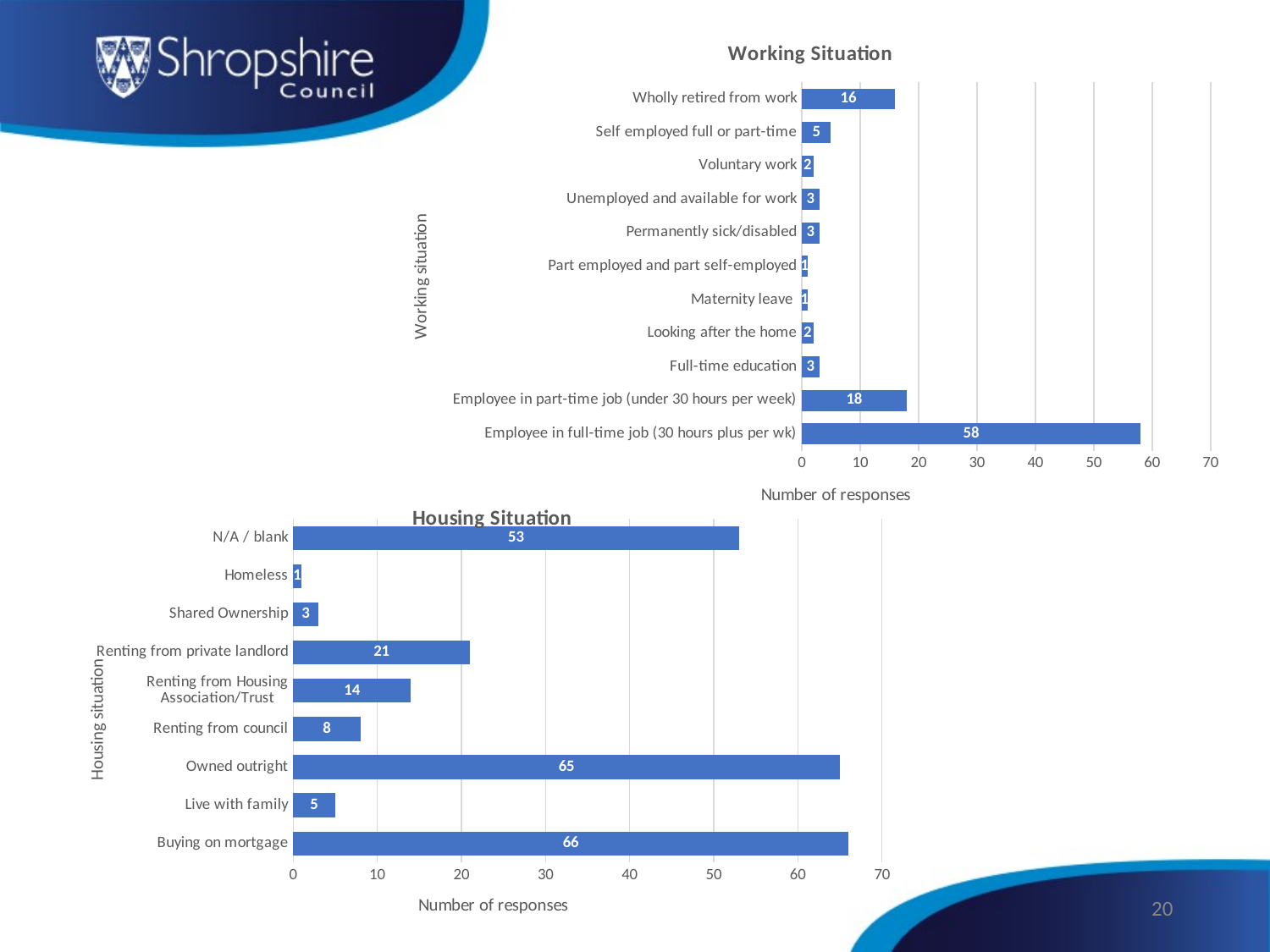
In the Working Situation chart, which category has the highest number of responses? Employee in full-time job (30 hours plus per wk) In the Working Situation chart, how many responses are there for 'Self employed full or part-time'? 5 In the Housing Situation chart, which category has the lowest number of responses? Homeless In the Housing Situation chart, which has more responses: 'Owned outright' or 'N/A / blank'? Owned outright In the Housing Situation chart, how many categories are plotted? 9 In the Working Situation chart, how many responses are there for 'Employee in full-time job (30 hours plus per wk)'? 58 In the Working Situation chart, how many categories are plotted? 11 In the Working Situation chart, what is the difference in responses between 'Employee in part-time job (under 30 hours per week)' and 'Wholly retired from work'? 2 In the Housing Situation chart, how many responses are there for 'Renting from private landlord'? 21 In the Housing Situation chart, which category has the highest number of responses? Buying on mortgage What type of chart is the Housing Situation chart? Bar chart In the Housing Situation chart, what is the difference in responses between 'Renting from Housing Association/Trust' and 'Renting from council'? 6